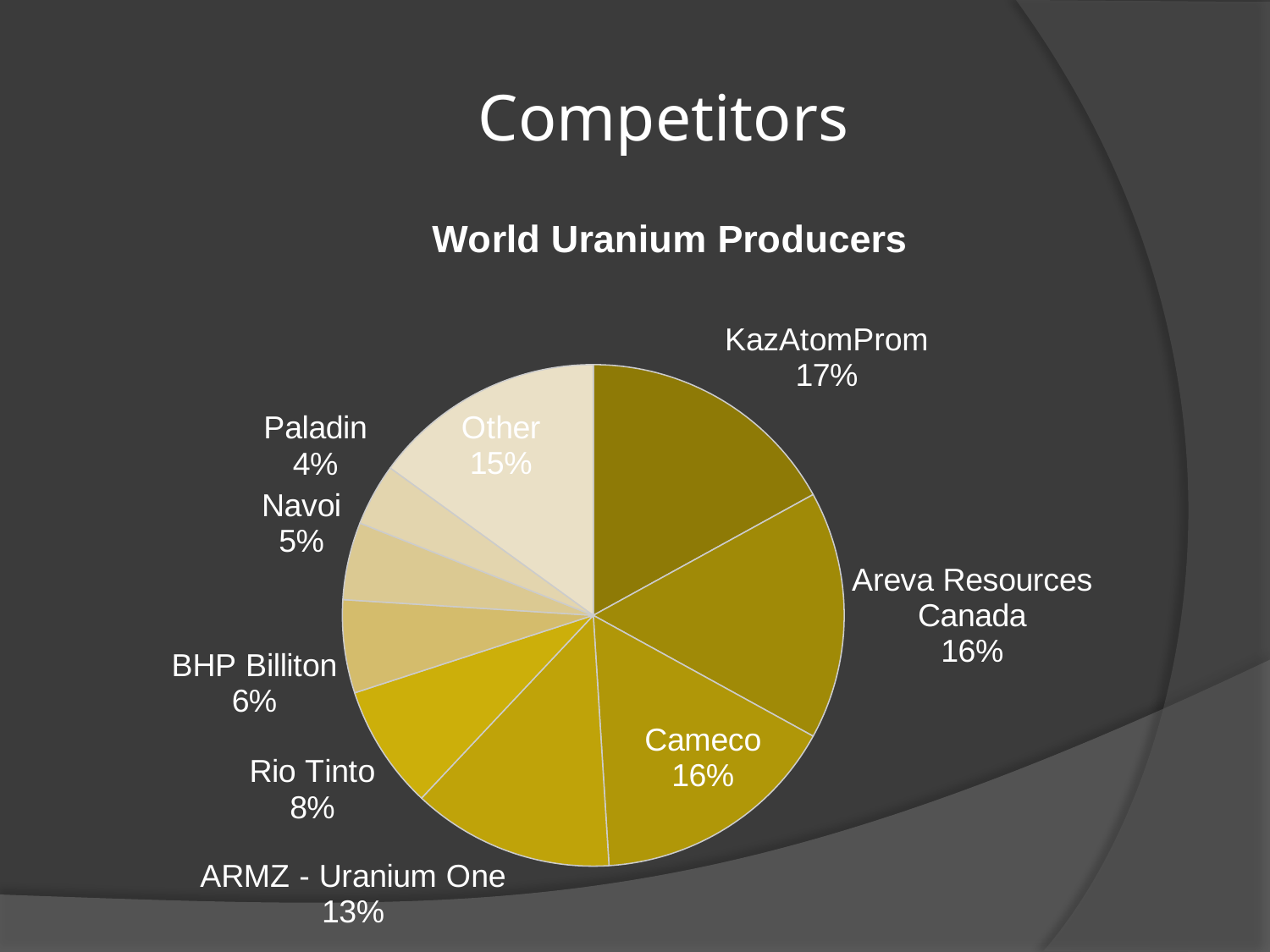
What is the value shown for ARMZ - Uranium One? 13% Which producer has the smallest slice of the pie? Paladin Which producer has the largest slice of the pie? KazAtomProm How many slices does the pie chart have? 9 What is the combined share of Areva Resources Canada and Cameco? 32% What is the difference between the shares of KazAtomProm and ARMZ - Uranium One? 4% Which is larger, the share for BHP Billiton or the share for Rio Tinto? Rio Tinto What share of the pie does KazAtomProm hold? 17% What is the value for Navoi? 5% What kind of chart is shown on the slide? pie chart What percentage is shown for Rio Tinto? 8% What is the title of the chart? World Uranium Producers